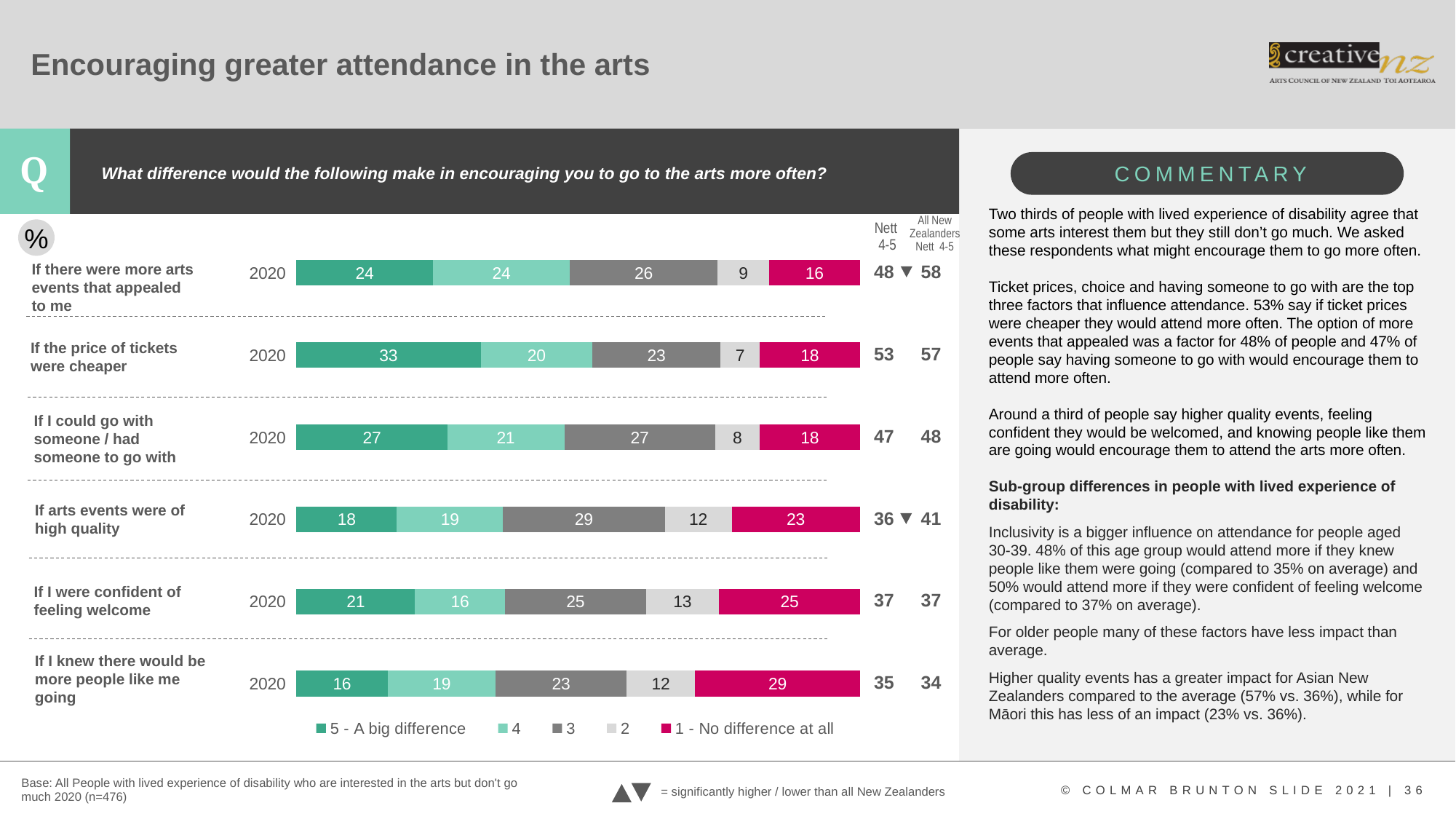
What type of chart is shown on the slide? Stacked bar chart What is the 'All New Zealanders Nett 4-5' value for 'If there were more arts events that appealed to me'? 58 How many statements (categories) are shown in the chart? 6 How many series does the legend list? 5 What percentage of respondents said cheaper ticket prices would make '5 - A big difference'? 33 What is the Nett 4-5 value for 'If I could go with someone / had someone to go with'? 47 Which statement has the highest '5 - A big difference' percentage? If the price of tickets were cheaper What colour represents '1 - No difference at all' in the chart? Pink/magenta Which is larger: the '1 - No difference at all' value for 'If arts events were of high quality' or for 'If the price of tickets were cheaper'? If arts events were of high quality Which statement has the lowest Nett 4-5 value? If I knew there would be more people like me going What is the difference between the Nett 4-5 value and the All New Zealanders Nett 4-5 value for 'If there were more arts events that appealed to me'? 10 What percentage said '1 - No difference at all' for 'If I knew there would be more people like me going'? 29